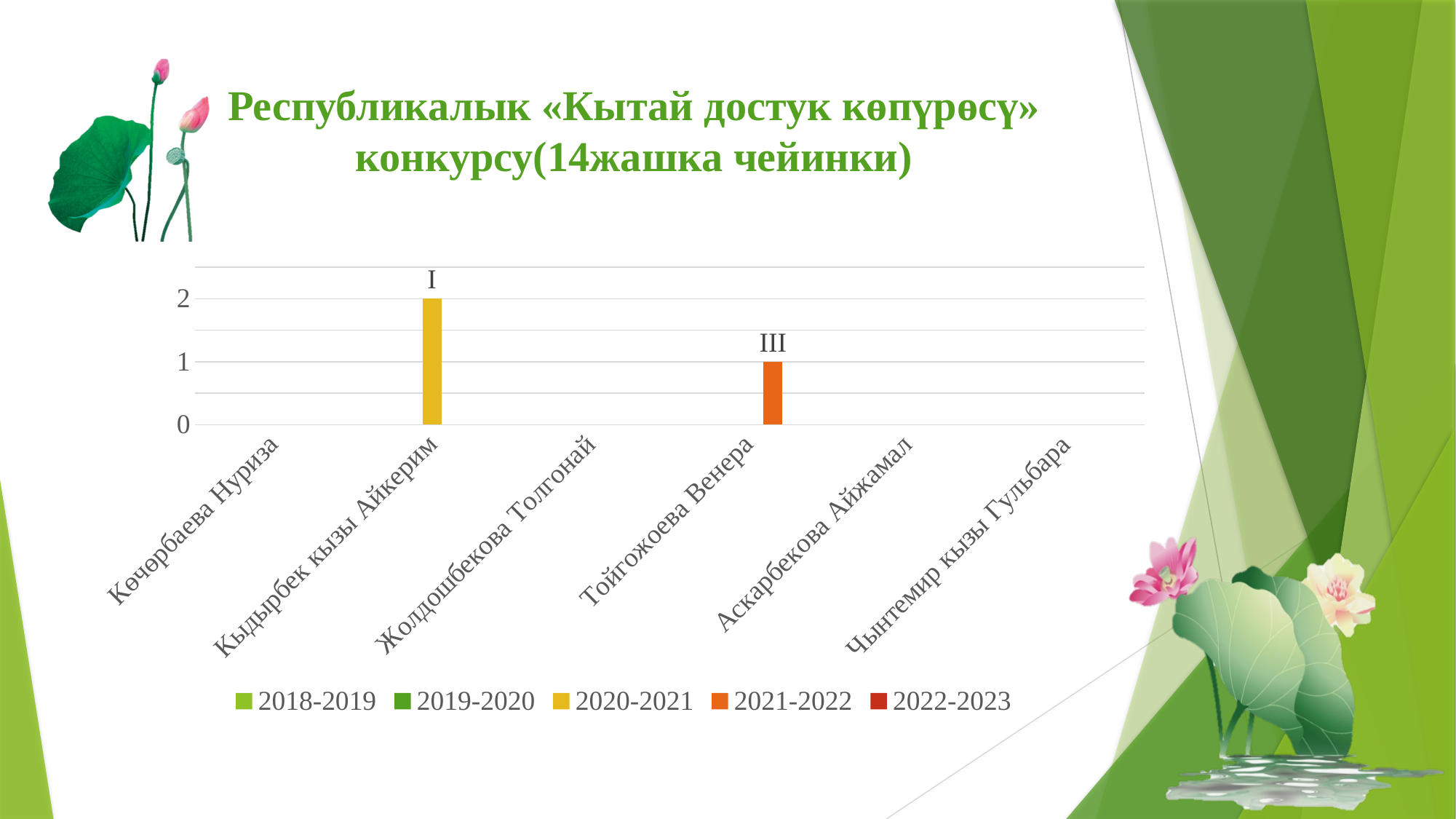
What label is printed above the bar for Тойгожоева Венера? III What kind of chart is shown on the slide? bar chart What is the difference between the bar heights for Кыдырбек кызы Айкерим and Тойгожоева Венера? 1 How many series does the legend list? 5 What value on the axis does the bar for Кыдырбек кызы Айкерим reach? 2 Which legend series does the bar for Тойгожоева Венера belong to? 2021-2022 Which legend series does the bar for Кыдырбек кызы Айкерим belong to? 2020-2021 Which bar is taller: Кыдырбек кызы Айкерим or Тойгожоева Венера? Кыдырбек кызы Айкерим What label is printed above the bar for Кыдырбек кызы Айкерим? I Which category has the tallest bar? Кыдырбек кызы Айкерим How many categories (names) are shown on the x axis? 6 What value on the axis does the bar for Тойгожоева Венера reach? 1